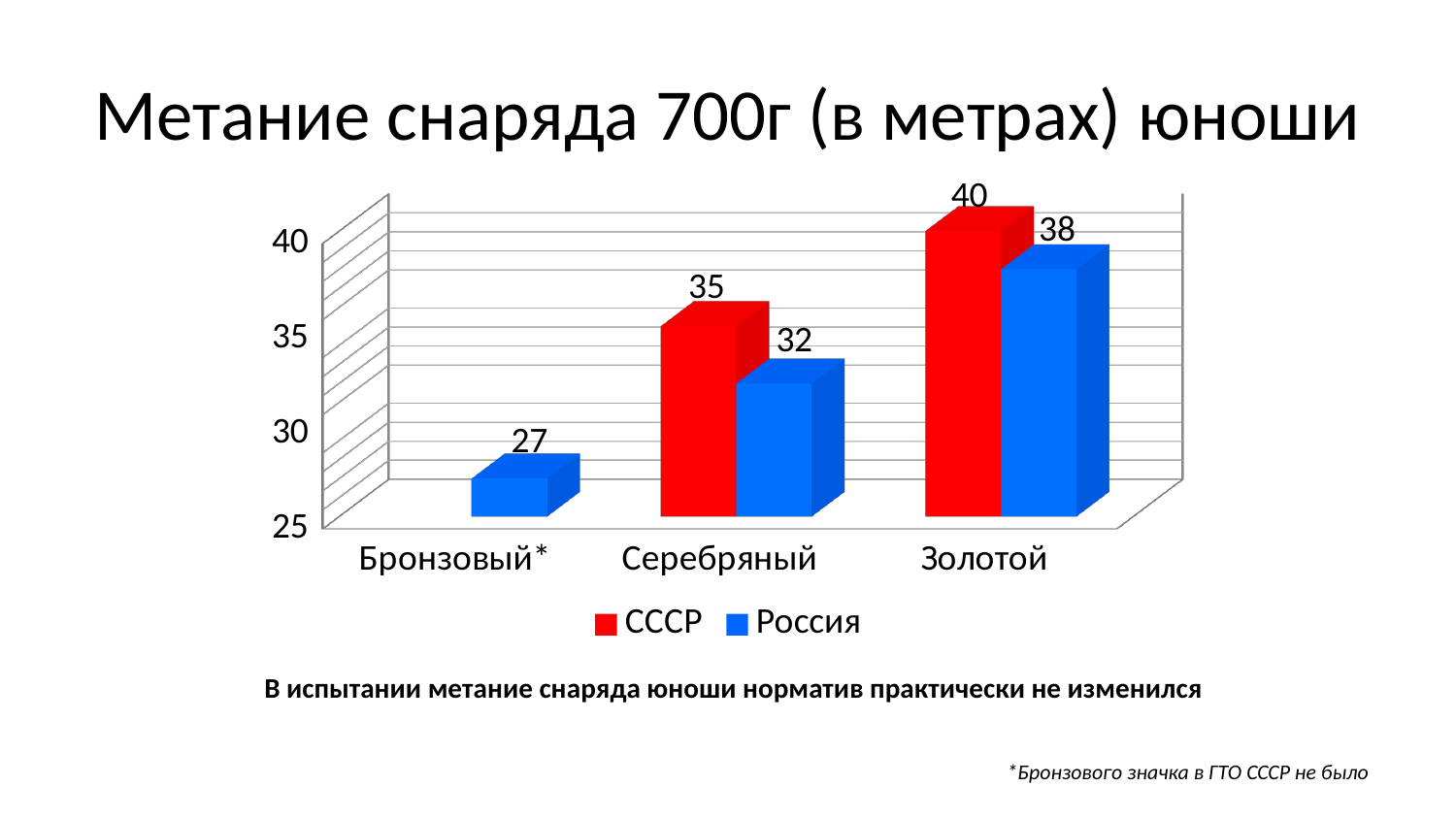
What is the value for СССР in the Золотой category? 40 What kind of chart is shown on the slide? Bar chart What is the value for Россия in the Бронзовый category? 27 How many series does the legend list? 2 Which category has the highest value for the Россия series? Золотой How many categories are shown on the x axis? 3 What is the value for Россия in the Золотой category? 38 What is the difference between the СССР and Россия values in the Серебряный category? 3 What is the value for СССР in the Серебряный category? 35 Which is larger in the Золотой category: the СССР value or the Россия value? СССР Which category has the lowest value for the Россия series? Бронзовый Do the Россия values rise or fall from Бронзовый to Золотой? Rise